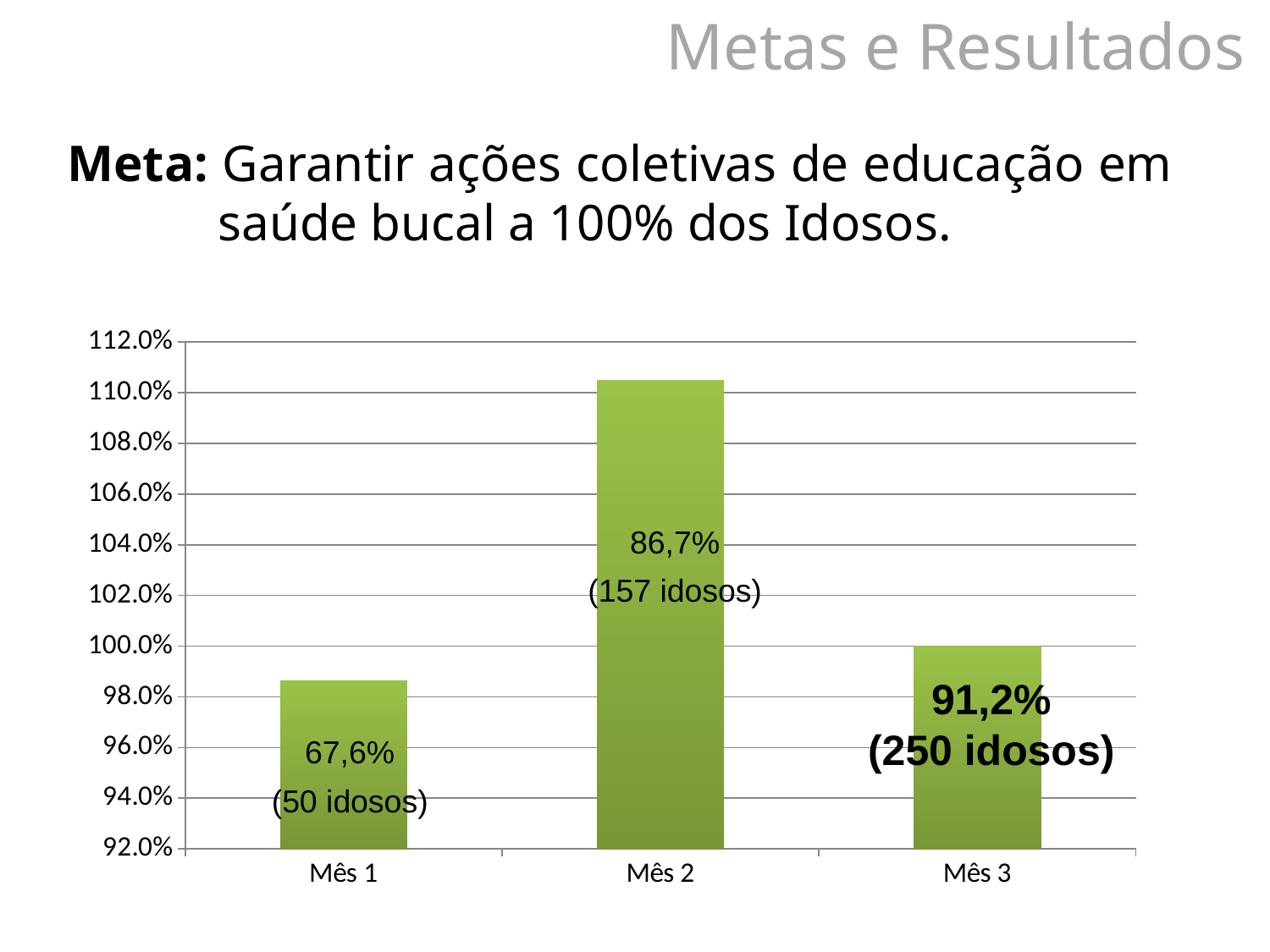
How many idosos are indicated for Mês 3? 250 idosos What is the difference between the number of idosos for Mês 3 and Mês 2? 93 What kind of chart is shown on the slide? Bar chart Which has more idosos according to the labels, Mês 1 or Mês 2? Mês 2 What is the highest value shown on the y axis of the chart? 112.0% What percentage is labelled on the bar for Mês 2? 86,7% What colour are the bars in the chart? Green How many idosos are indicated for Mês 1? 50 idosos What percentage is labelled on the bar for Mês 3? 91,2% How many idosos are indicated for Mês 2? 157 idosos What percentage is labelled on the bar for Mês 1? 67,6% How many categories (months) are shown on the x axis of the chart? 3